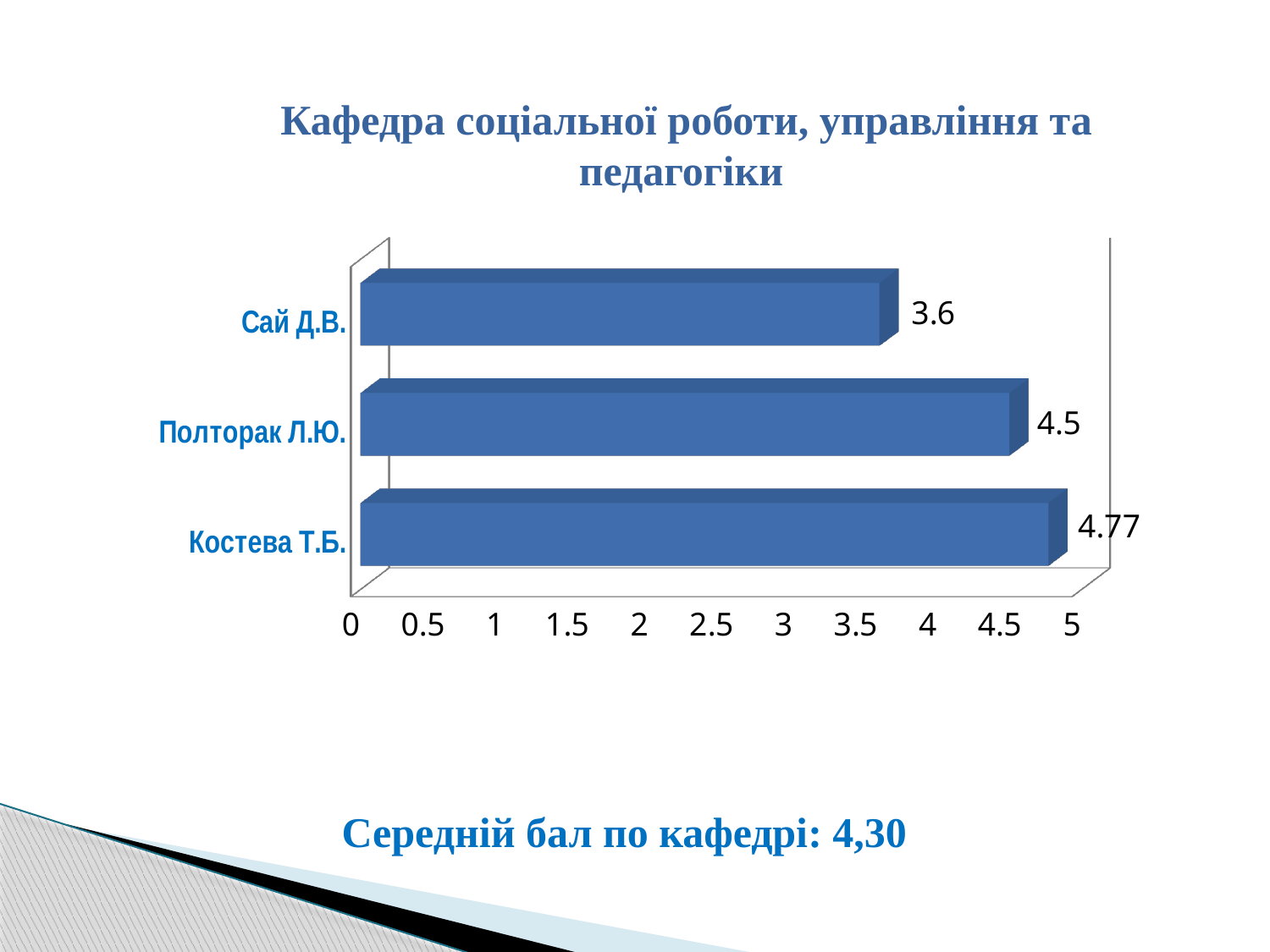
What is the difference between the values for Костева Т.Б. and Сай Д.В.? 1.17 What is the title of the chart? Кафедра соціальної роботи, управління та педагогіки What is the value for Костева Т.Б.? 4.77 Which category has the highest value? Костева Т.Б. What is the difference between the values for Полторак Л.Ю. and Сай Д.В.? 0.9 Which category has the lowest value? Сай Д.В. How many categories are shown in the chart? 3 What is the value for Сай Д.В.? 3.6 Is the value for Сай Д.В. greater or less than 4? less Which is larger, the value for Полторак Л.Ю. or the value for Сай Д.В.? Полторак Л.Ю. What is the value for Полторак Л.Ю.? 4.5 What kind of chart is shown on the slide? bar chart